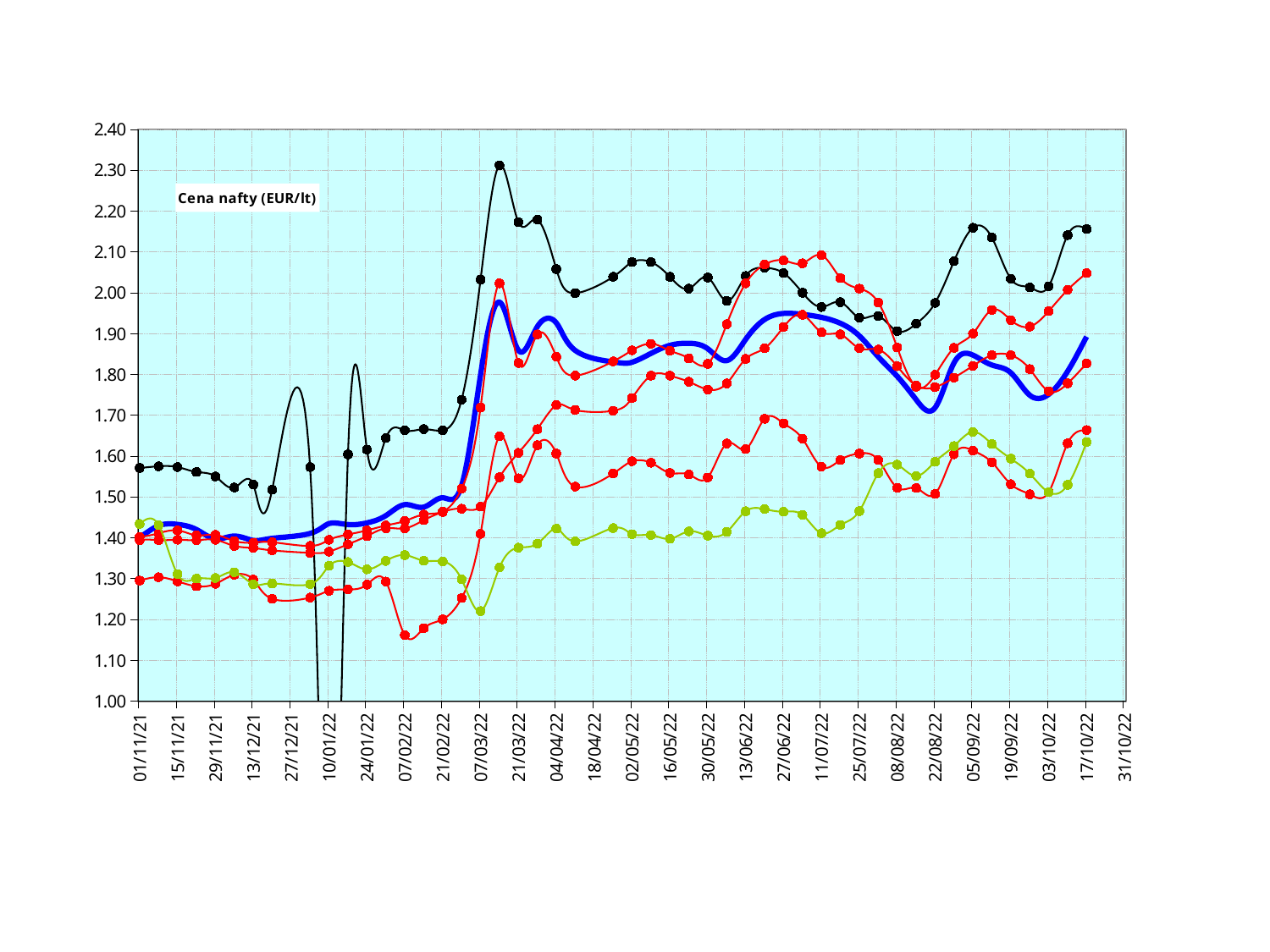
Which line reaches the highest value on the chart? the black line Is the value of the black line at 17/10/22 greater or less than 2.10? greater Does the green line overall rise or fall from 01/11/21 to 17/10/22? rise What is the highest value shown on the vertical axis? 2.40 Is the value of the thick blue line at 17/10/22 greater or less than 2.00? less How many date labels are shown on the horizontal axis? 27 What is the title printed inside the chart area? Cena nafty (EUR/lt) At 17/10/22, which is higher: the black line or the green line? the black line What kind of chart is shown on the slide? line chart Is the value of the green line at 07/03/22 greater or less than 1.30? less